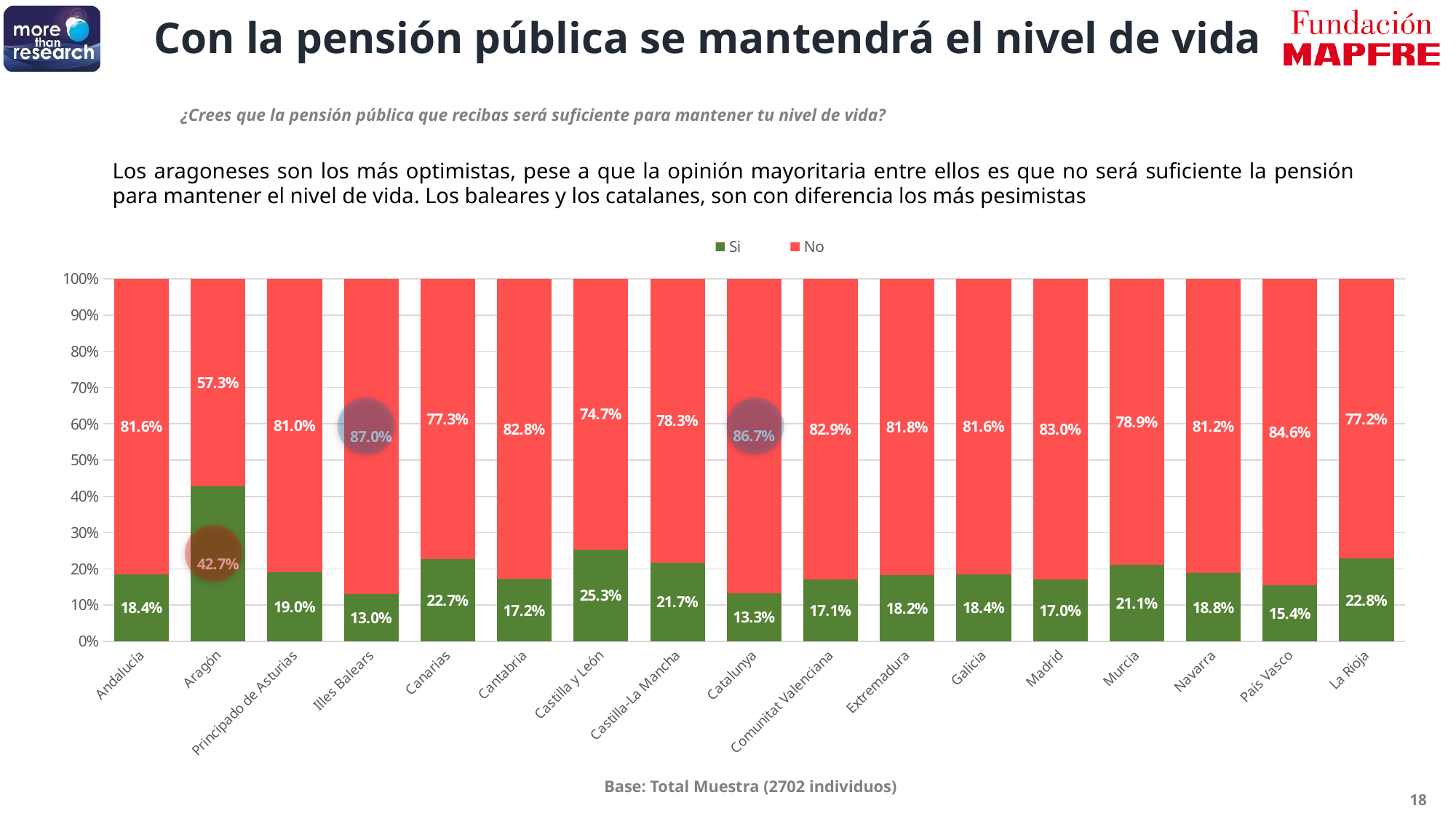
What type of chart is shown on the slide? Stacked bar chart What is the 'Si' value for Castilla y León? 25.3% Which region has the highest 'No' value? Illes Balears How many regions (categories) are shown on the x axis? 17 What is the 'Si' value for Aragón? 42.7% Which has a larger 'Si' value, Canarias or Murcia? Canarias How many series does the legend list? 2 Which region has the lowest 'No' value? Aragón Which region has the highest 'Si' value? Aragón What is the total of the stacked bar for Galicia? 100% What is the 'No' value for Illes Balears? 87.0% What is the difference between the 'No' value for Catalunya and the 'No' value for Madrid? 3.7%